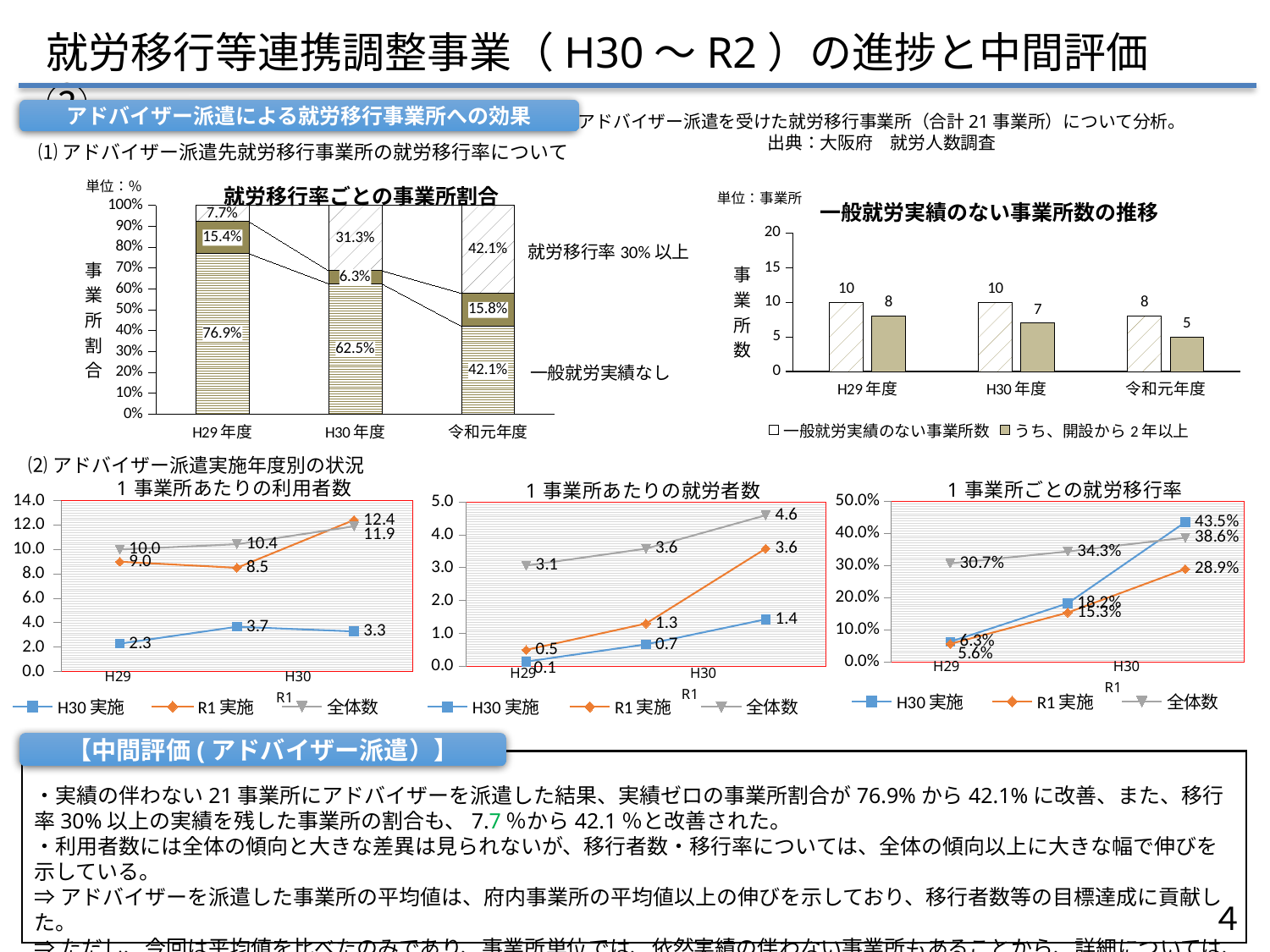
In the chart titled 1事業所あたりの利用者数, which series has the lowest value at H29? H30実施 In the chart titled 一般就労実績のない事業所数の推移, what is the value of 一般就労実績のない事業所数 for H30年度? 10 In the chart titled 1事業所あたりの就労者数, does the R1実施 series rise or fall from H29 to R1? Rise In the chart titled 1事業所あたりの利用者数, what is the value of R1実施 at R1? 12.4 In the chart titled 就労移行率ごとの事業所割合, what is the share of 就労移行率30%以上 for 令和元年度? 42.1% In the chart titled 1事業所あたりの就労者数, what is the value of 全体数 at R1? 4.6 In the chart titled 1事業所ごとの就労移行率, which series has the highest value at R1? H30実施 In the chart titled 就労移行率ごとの事業所割合, what kind of chart is it? Stacked bar chart In the chart titled 就労移行率ごとの事業所割合, what is the share of 一般就労実績なし for H29年度? 76.9% In the chart titled 一般就労実績のない事業所数の推移, what is the difference between 一般就労実績のない事業所数 and うち、開設から2年以上 for H30年度? 3 In the chart titled 一般就労実績のない事業所数の推移, how many series does the legend list? 2 In the chart titled 一般就労実績のない事業所数の推移, what is the value of うち、開設から2年以上 for 令和元年度? 5